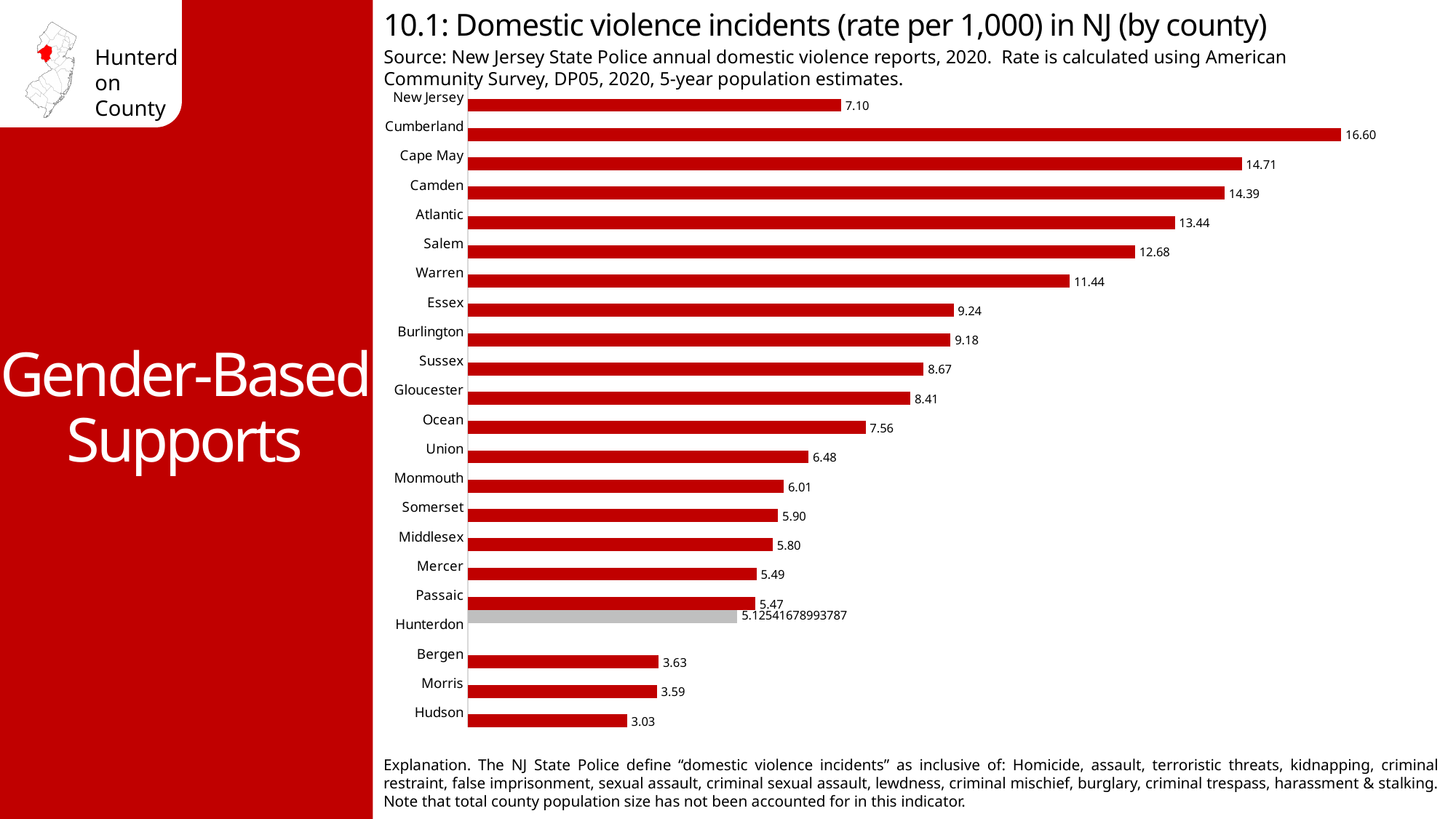
Which county has the highest domestic violence incident rate? Cumberland How many bars (categories) are shown in the chart? 22 What is the domestic violence incident rate per 1,000 for Cumberland county? 16.60 Which county has the lowest domestic violence incident rate? Hudson Which has a higher rate, Salem or Essex? Salem What type of chart is used on this slide? Bar chart What is the difference between the rates for Cape May and Camden? 0.32 What value is printed for Hunterdon county? 5.12541678993787 Which has a higher rate, Ocean or New Jersey overall? Ocean What is the difference between the rates for Cumberland and Hudson? 13.57 What is the domestic violence incident rate per 1,000 for Warren county? 11.44 What is the rate per 1,000 shown for New Jersey overall? 7.10